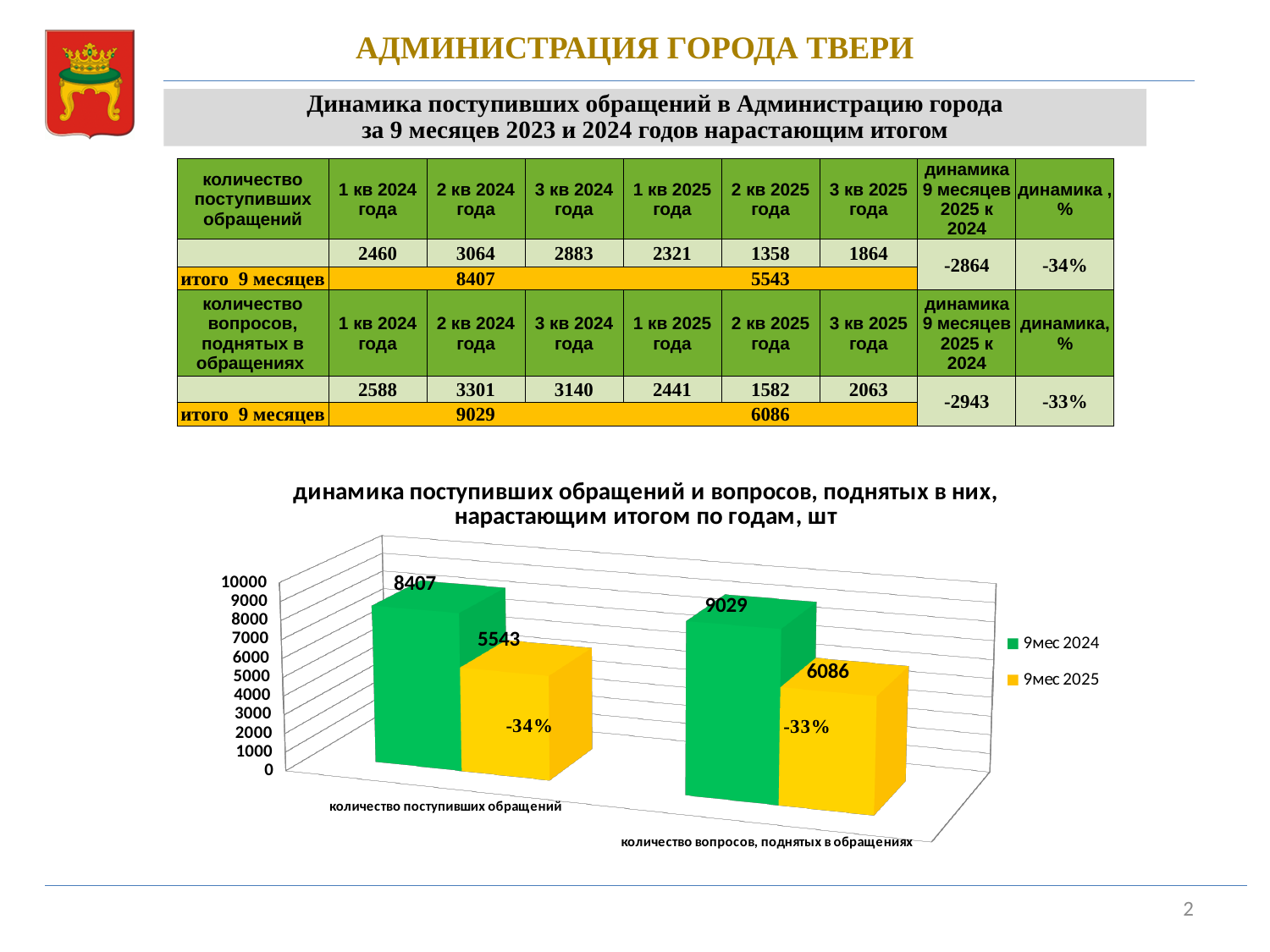
What type of chart is shown on the slide? bar chart How many categories are shown on the x axis of the chart? 2 Which bar has the lowest value on the chart? 9мес 2025, количество поступивших обращений What is the difference between the "9мес 2024" and "9мес 2025" values for "количество поступивших обращений"? 2864 Which bar has the highest value on the chart? 9мес 2024, количество вопросов, поднятых в обращениях What is the value for "9мес 2024" in the category "количество поступивших обращений"? 8407 What is the difference between the "9мес 2024" and "9мес 2025" values for "количество вопросов, поднятых в обращениях"? 2943 What is the value for "9мес 2024" in the category "количество вопросов, поднятых в обращениях"? 9029 What is the value for "9мес 2025" in the category "количество вопросов, поднятых в обращениях"? 6086 Which is larger: the "9мес 2025" value for "количество поступивших обращений" or the "9мес 2025" value for "количество вопросов, поднятых в обращениях"? количество вопросов, поднятых в обращениях How many series does the chart legend list? 2 What is the value for "9мес 2025" in the category "количество поступивших обращений"? 5543